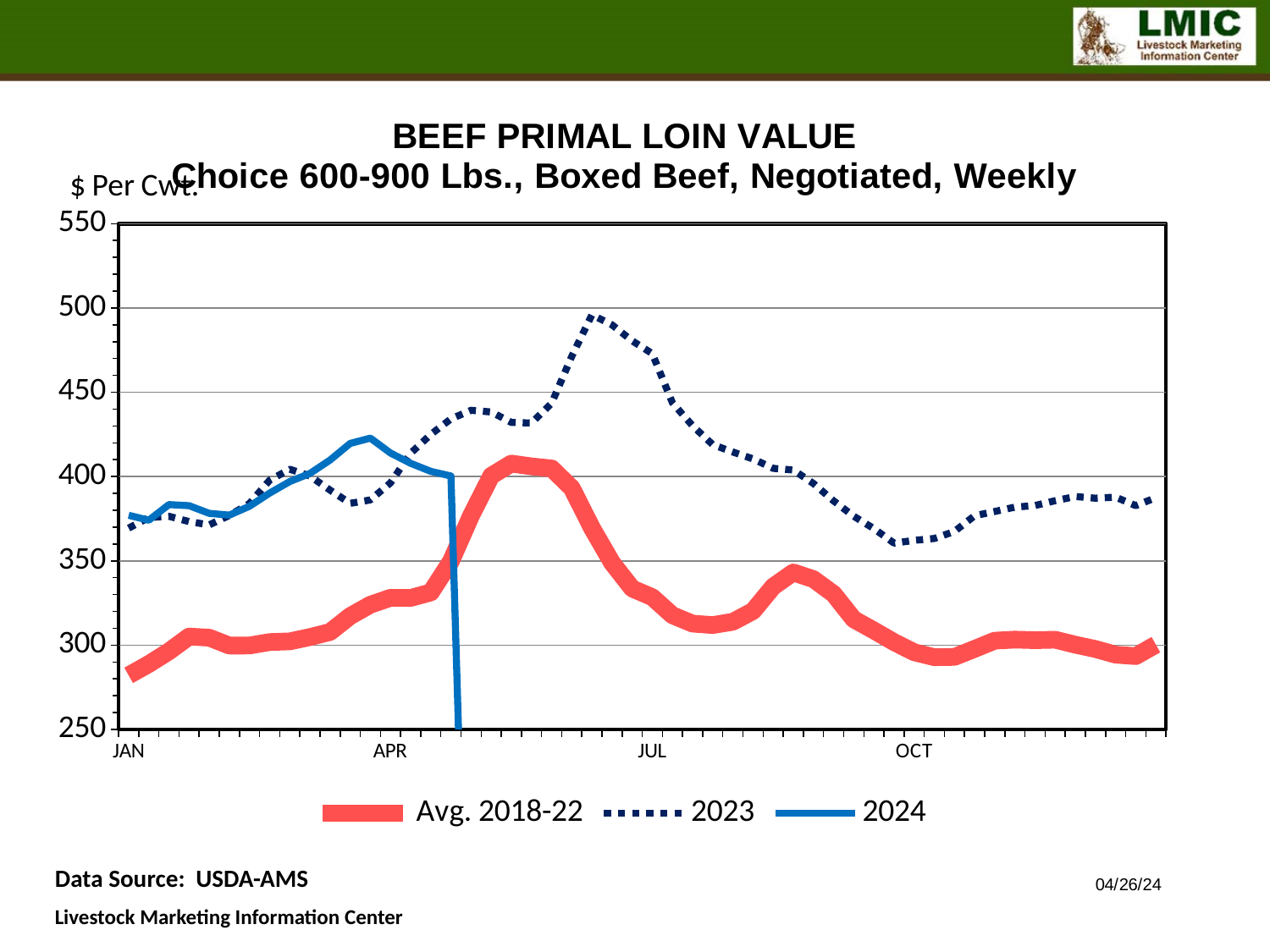
Does the Avg. 2018-22 series rise or fall from January to April? rise Is the value of the Avg. 2018-22 series in July greater or less than 350? less How many series does the legend list? 3 In January, which is higher: the 2024 series or the Avg. 2018-22 series? 2024 Is the highest value reached by the 2024 series greater or less than 400? greater Is the peak value of the 2023 series greater or less than 450? greater What kind of chart is shown on the slide? line chart Which series reaches the highest value on the chart? 2023 Does the 2023 series rise or fall from July to October? fall What unit label is shown on the y axis? $ Per Cwt. What are the three series listed in the legend? Avg. 2018-22, 2023, 2024